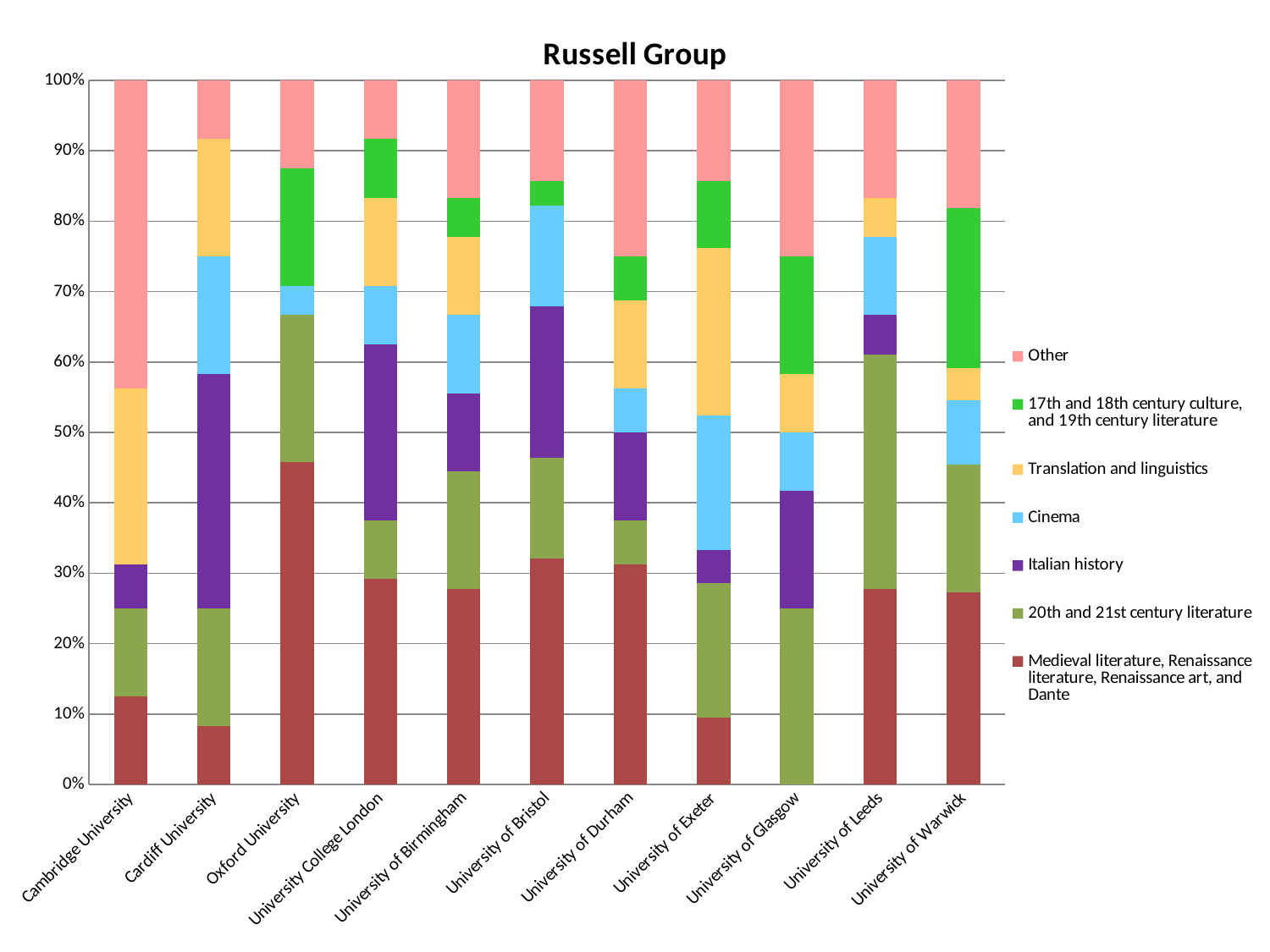
How many universities are shown along the x axis? 11 Is the 'Medieval literature, Renaissance literature, Renaissance art, and Dante' value for Oxford University greater or less than 40%? greater Which university has the largest 'Medieval literature, Renaissance literature, Renaissance art, and Dante' segment? Oxford University Which university has no 'Medieval literature, Renaissance literature, Renaissance art, and Dante' segment at all? University of Glasgow Is the 'Medieval literature, Renaissance literature, Renaissance art, and Dante' segment larger for Oxford University or Cambridge University? Oxford University What kind of chart is shown on the slide? Stacked bar chart How many series does the legend list? 7 What is the total of the stacked bar for University of Bristol? 100% Is the 'Medieval literature, Renaissance literature, Renaissance art, and Dante' value for Cardiff University greater or less than 10%? less What is the title of the chart? Russell Group Which series is shown in light blue in the legend? Cinema Is the 'Medieval literature, Renaissance literature, Renaissance art, and Dante' value for University of Leeds greater or less than 30%? less